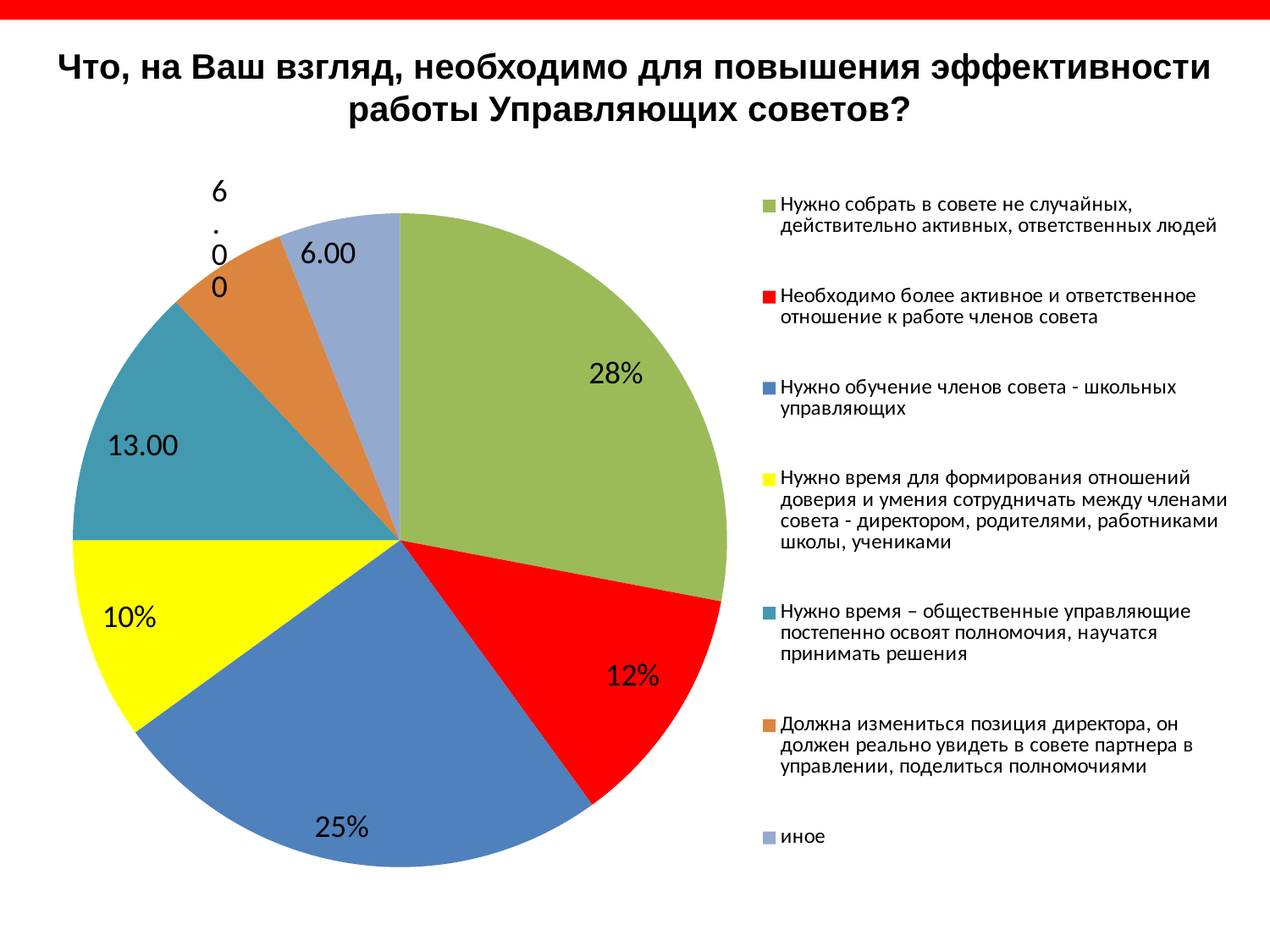
What is the value shown for the slice "Нужно время – общественные управляющие постепенно освоят полномочия, научатся принимать решения"? 13.00 What colour is the slice labelled "иное" in the legend? light blue What is the value shown for the slice "иное"? 6.00 What is the value shown for the yellow slice ("Нужно время для формирования отношений доверия...")? 10% What is the value shown for the slice "Необходимо более активное и ответственное отношение к работе членов совета"? 12% How many slices does the pie chart have? 7 What type of chart is shown on the slide? pie chart Which category has the largest slice of the pie? Нужно собрать в совете не случайных, действительно активных, ответственных людей Which slice is larger: "Нужно обучение членов совета - школьных управляющих" or "Необходимо более активное и ответственное отношение к работе членов совета"? Нужно обучение членов совета - школьных управляющих What is the difference between the largest slice (28%) and the slice for "Нужно обучение членов совета - школьных управляющих" (25%)? 3% What is the value shown for the slice "Нужно обучение членов совета - школьных управляющих"? 25% What is the value shown for the slice "Нужно собрать в совете не случайных, действительно активных, ответственных людей"? 28%